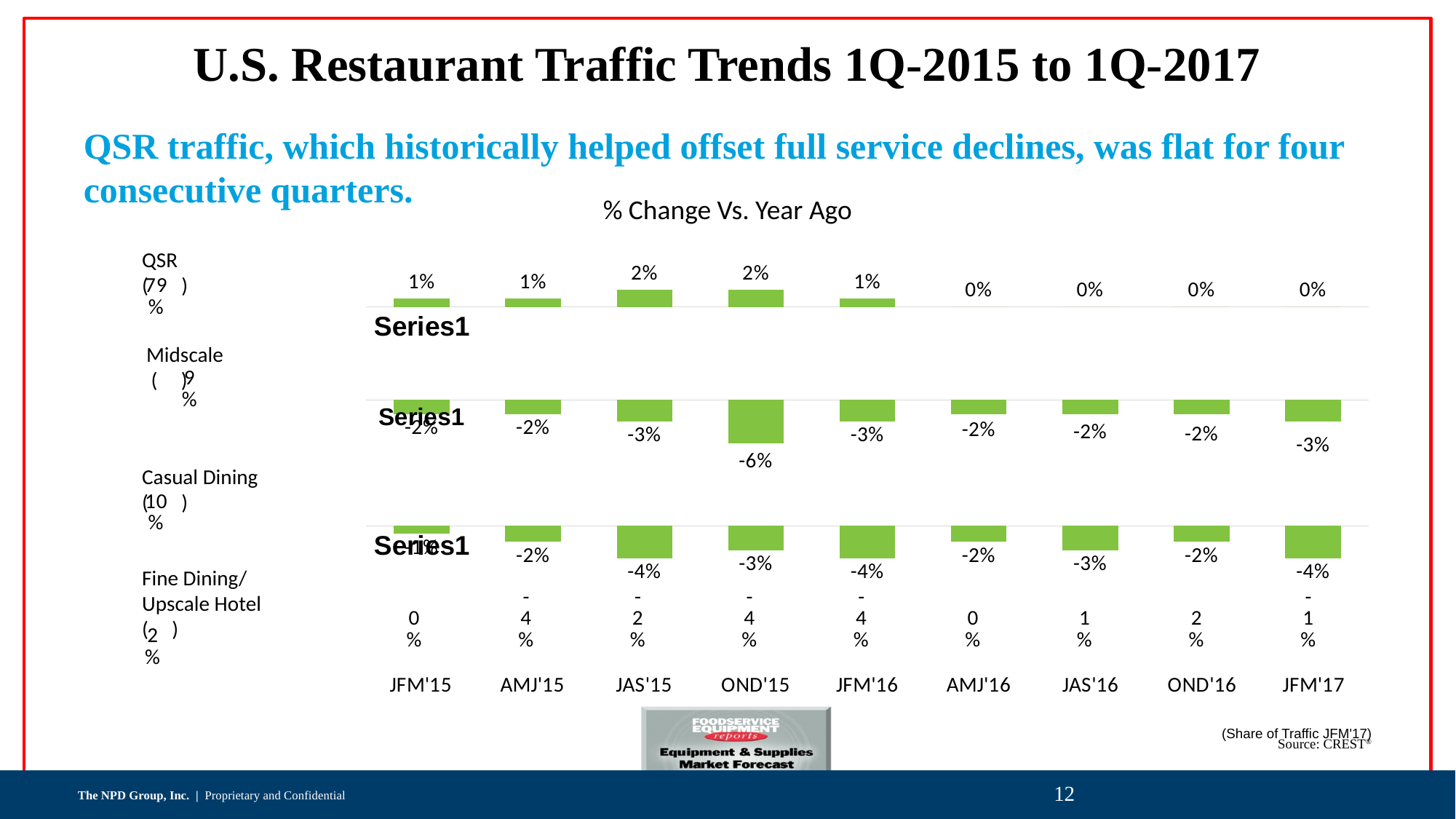
In which quarter is the Midscale % change vs. year ago lowest? OND'15 How many quarters are shown along the x axis of the chart? 9 What is the Midscale % change vs. year ago for OND'15? -6% What is the QSR % change vs. year ago for JAS'15? 2% What is the Casual Dining % change vs. year ago for JFM'17? -4% What is the QSR % change vs. year ago for JFM'17? 0% What is the Casual Dining % change vs. year ago for JAS'16? -3% What kind of chart is shown on the slide? bar chart Do the QSR values rise or fall from JFM'16 to JFM'17? fall What is the title of the chart? % Change Vs. Year Ago What is the difference between the Casual Dining values for JAS'15 and AMJ'16? 2 percentage points Which is larger for OND'15: the QSR value or the Midscale value? QSR